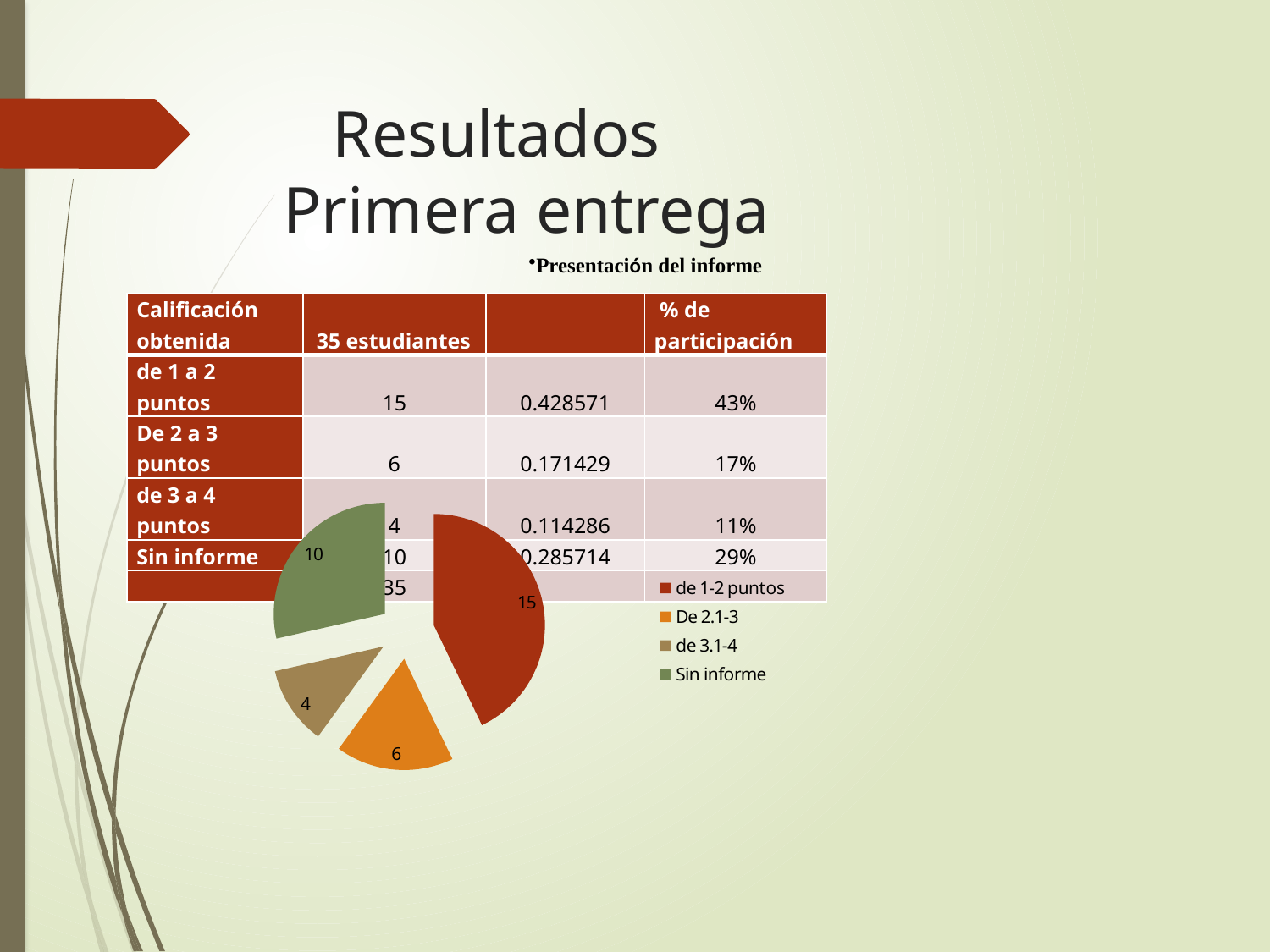
How many slices does the pie chart have? 4 What kind of chart is shown on the slide? pie chart What colour is the 'de 1-2 puntos' slice in the pie chart? dark red Which category has the largest slice in the pie chart? de 1-2 puntos What is the value of the 'de 1-2 puntos' slice in the pie chart? 15 How many entries does the pie chart's legend list? 4 Which category has the smallest slice in the pie chart? de 3.1-4 Which slice is larger in the pie chart, 'Sin informe' or 'De 2.1-3'? Sin informe What is the difference between the 'de 1-2 puntos' slice and the 'Sin informe' slice in the pie chart? 5 What is the value of the 'De 2.1-3' slice in the pie chart? 6 What is the value of the 'de 3.1-4' slice in the pie chart? 4 What is the value of the 'Sin informe' slice in the pie chart? 10